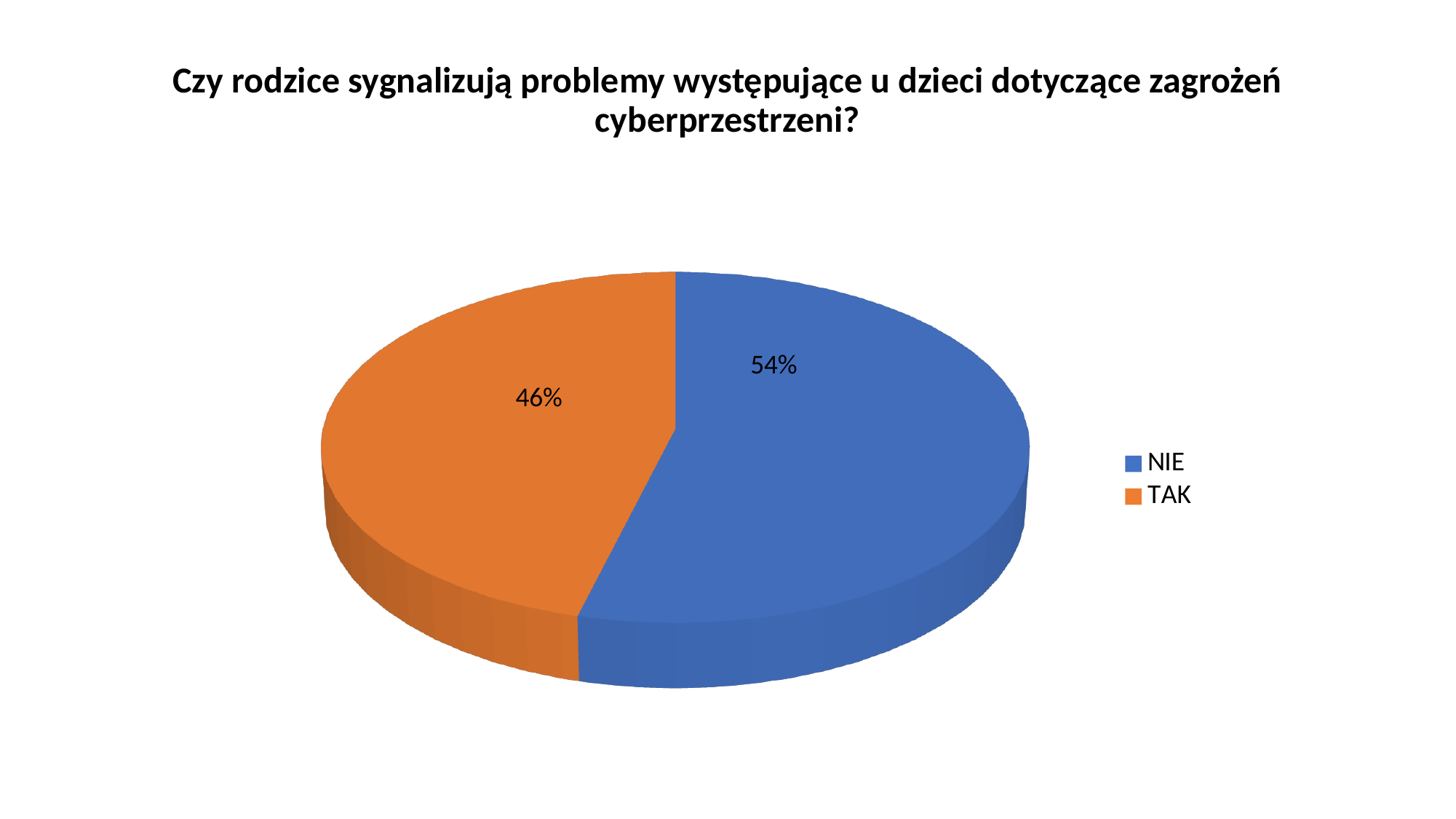
What colour is the NIE slice? Blue What share of the pie does NIE represent? 54% What share of the pie does TAK represent? 46% Which slice is larger, NIE or TAK? NIE What is the difference in percentage points between the NIE and TAK slices? 8 Which category has the smallest slice of the pie? TAK What is the title of the chart? Czy rodzice sygnalizują problemy występujące u dzieci dotyczące zagrożeń cyberprzestrzeni? What kind of chart is shown on the slide? Pie chart How many slices does the pie chart have? 2 How many entries does the legend list? 2 Which category has the largest slice of the pie? NIE